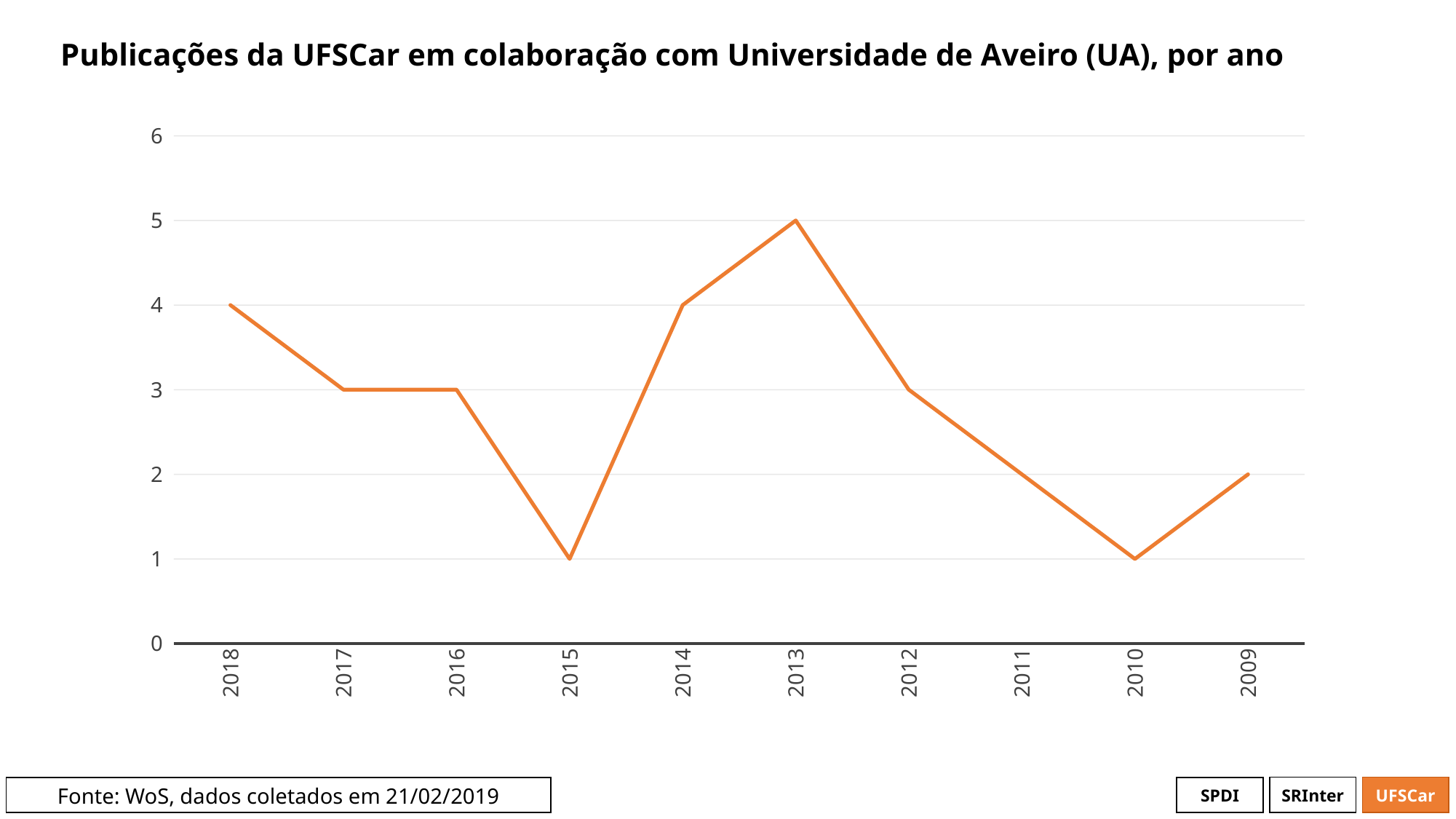
Is the value for 2013 greater or less than 4? greater What is the value for 2013? 5 What is the title of the chart? Publicações da UFSCar em colaboração com Universidade de Aveiro (UA), por ano Do the values rise or fall from 2016 to 2015 along the x axis? fall What kind of chart is shown on the slide? line chart What is the value for 2018? 4 Which year has the highest value? 2013 What is the value for 2009? 2 Which is larger, the value for 2014 or the value for 2012? 2014 How many years are shown on the x axis? 10 What is the difference between the values for 2013 and 2015? 4 What is the value for 2015? 1